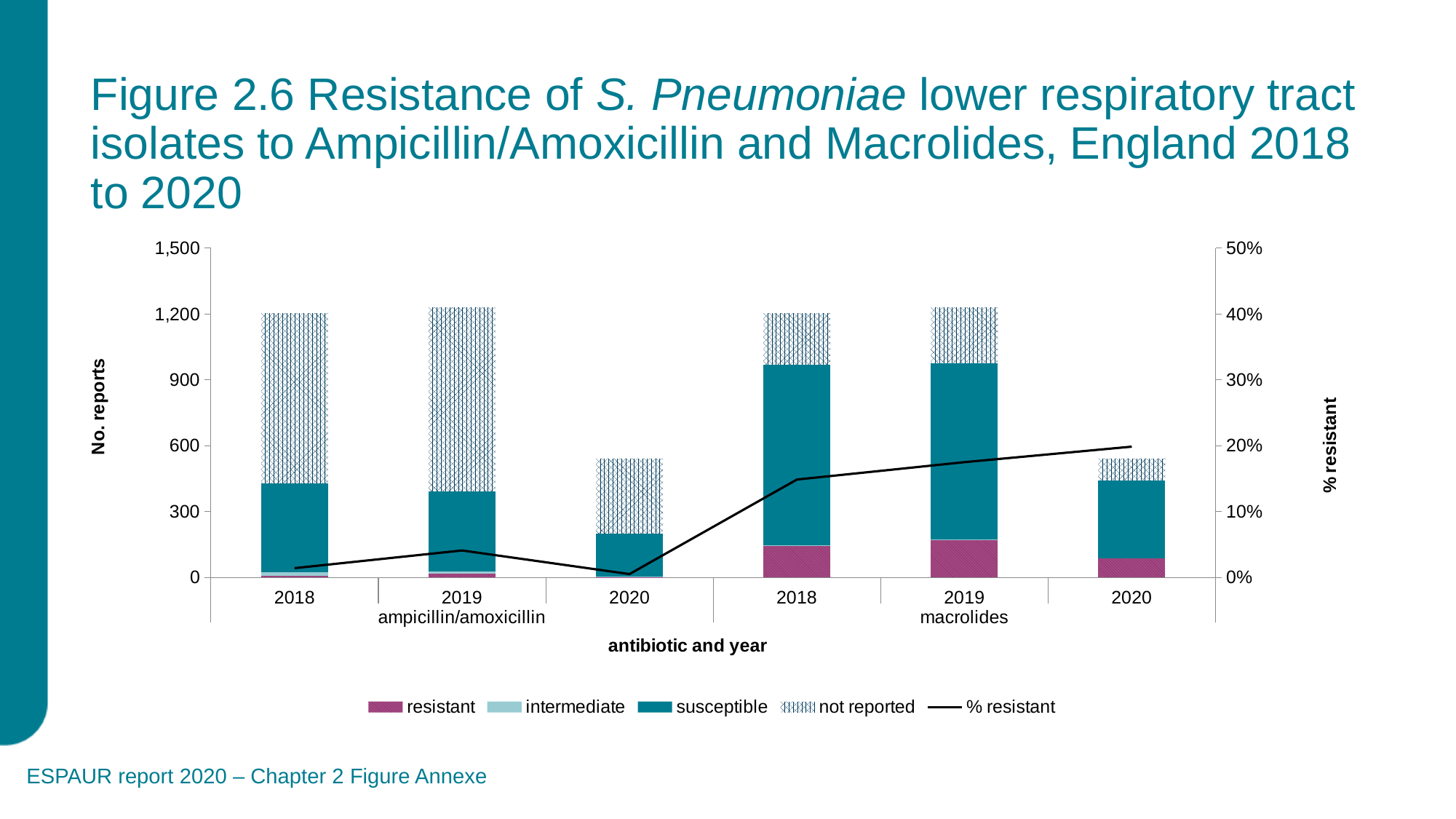
Which has the higher % resistant in 2018: ampicillin/amoxicillin or macrolides? macrolides Which legend entry is shown with a hatched pattern? not reported Which antibiotic and year has the lowest % resistant? ampicillin/amoxicillin 2020 How many stacked bars are plotted in the chart? 6 How many series does the legend list? 5 Is the total number of reports for ampicillin/amoxicillin in 2020 greater or less than 600? less What kind of chart is shown on the slide? bar chart with a line Is the % resistant value for macrolides in 2020 greater or less than 10%? greater Which has the larger total number of reports: macrolides 2019 or macrolides 2020? macrolides 2019 Is the % resistant value for ampicillin/amoxicillin in 2019 greater or less than 10%? less Which antibiotic and year has the highest % resistant? macrolides 2020 Does the % resistant line for macrolides rise or fall from 2018 to 2020? rise